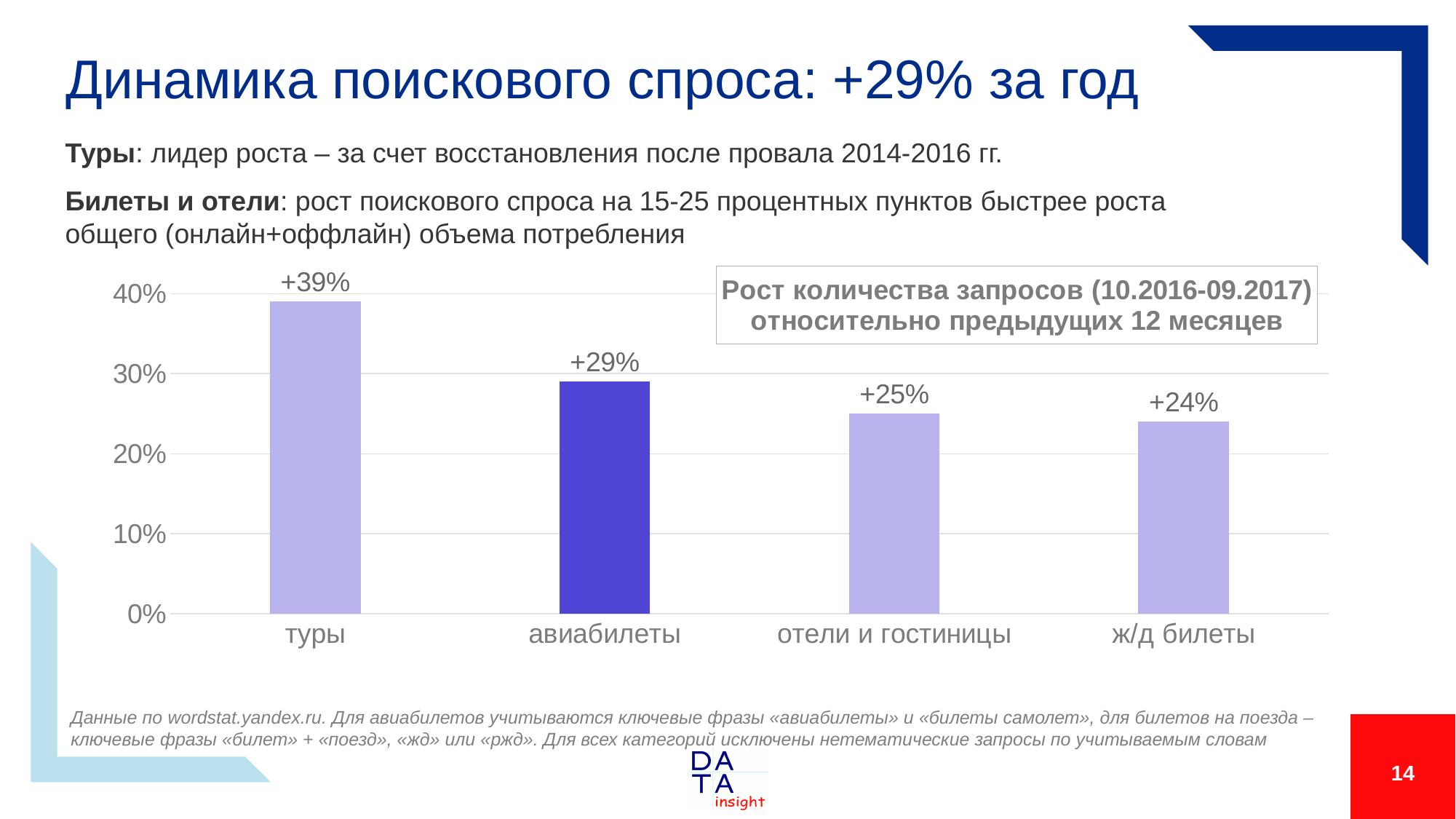
Which bar is drawn in a darker shade of blue than the others? авиабилеты What is the difference in percentage points between туры and авиабилеты? 10 Which category has the lowest growth? ж/д билеты What is the value shown for туры? +39% What is the value shown for ж/д билеты? +24% What is the value shown for авиабилеты? +29% Which category has the highest growth? туры How many categories are shown on the chart? 4 What kind of chart is shown on the slide? bar chart What is the value shown for отели и гостиницы? +25% Do the values rise or fall from left to right along the x axis? fall Which is larger, the value for авиабилеты or the value for отели и гостиницы? авиабилеты